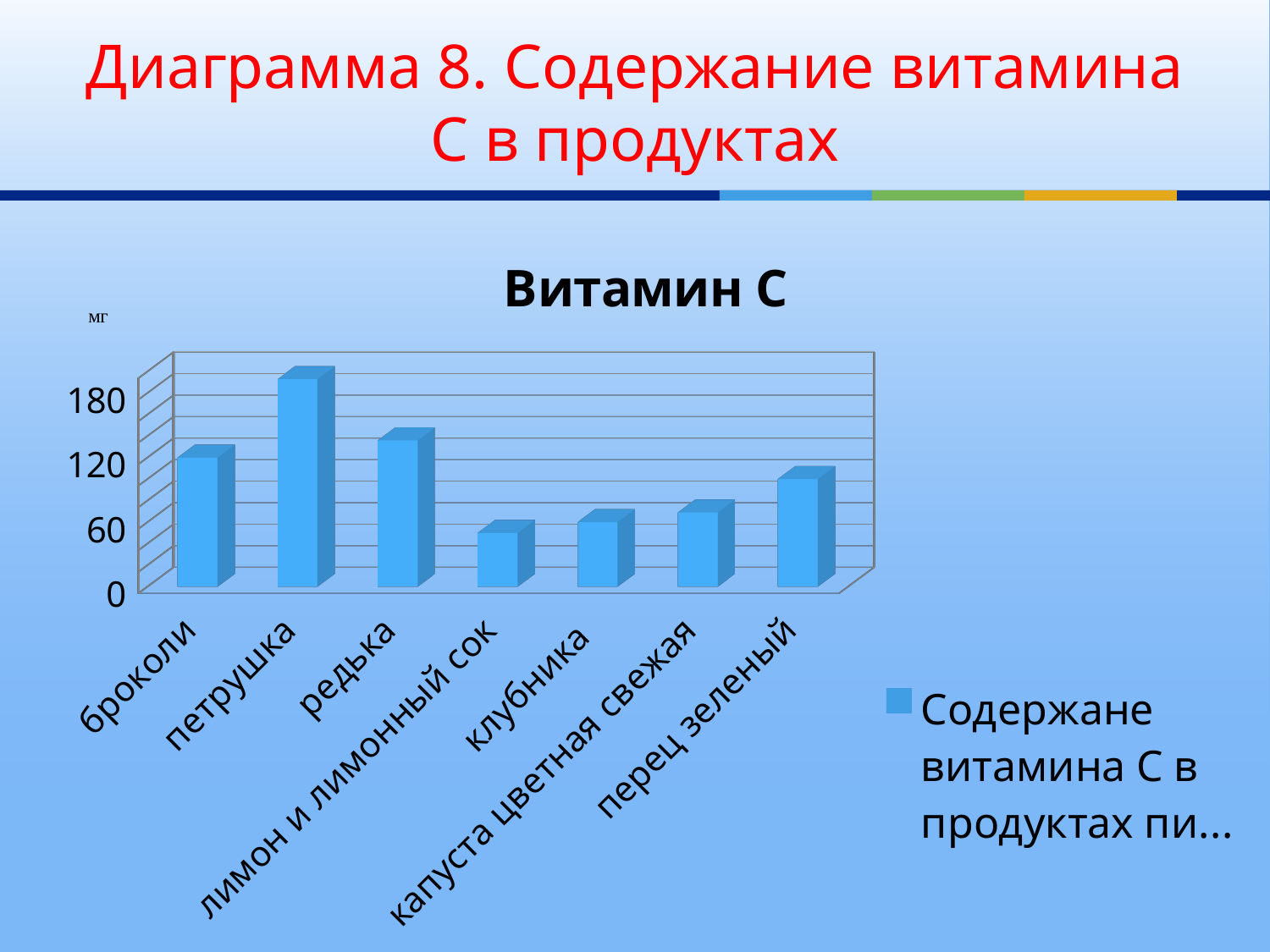
How many series does the chart legend list? 1 Which product has the highest vitamin C content in the chart? петрушка Is the value for капуста цветная свежая greater or less than 60? greater Is the value for перец зеленый greater or less than 120? less Which has a higher value, броколи or клубника? броколи What is the title of the chart? Витамин С Is the value for петрушка greater or less than 180? greater What kind of chart is shown on the slide? bar chart How many product categories are shown on the x axis of the chart? 7 Which has a higher value, петрушка or редька? петрушка What unit is shown on the vertical axis of the chart? мг